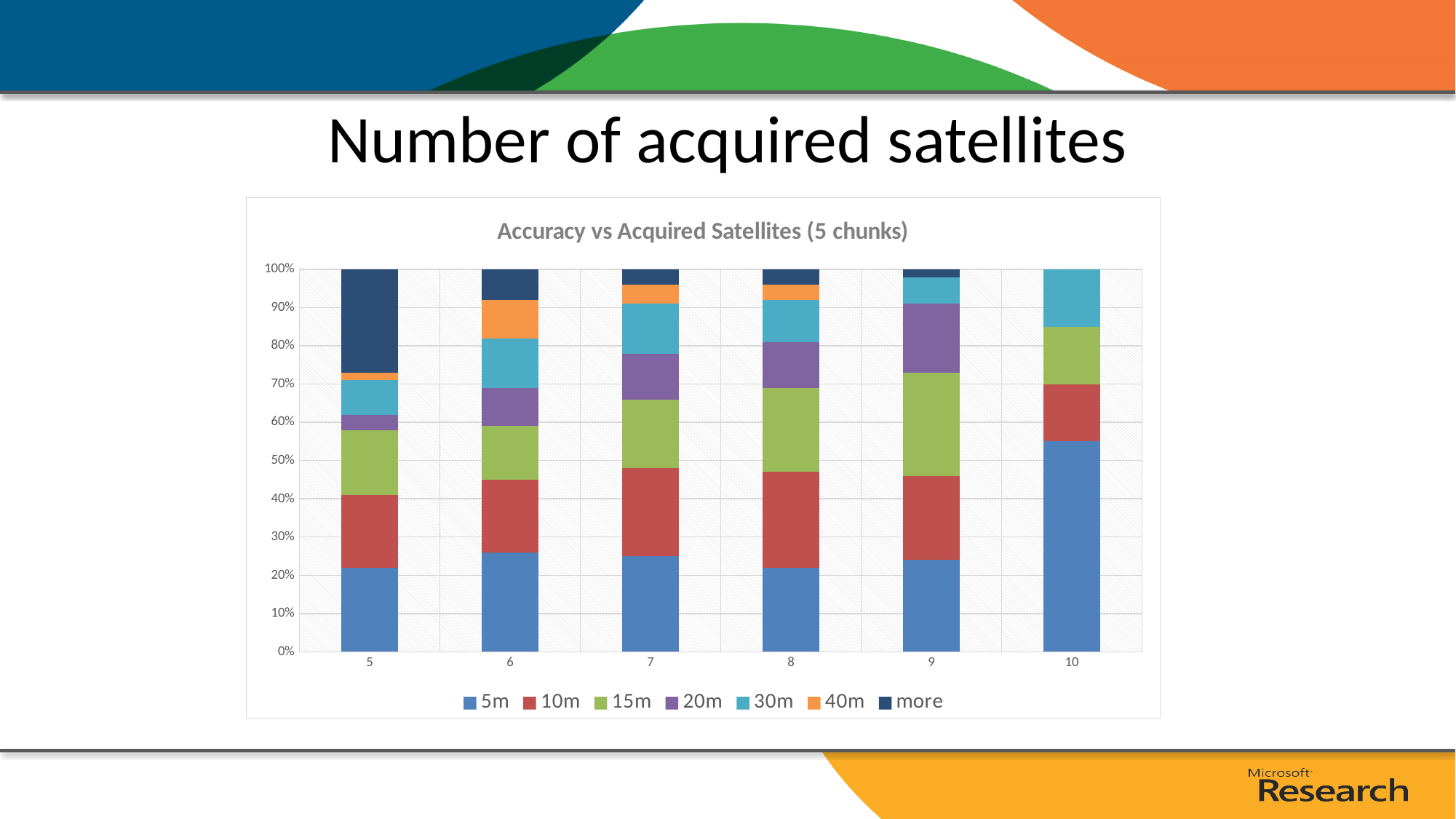
How many series does the legend list? 7 How many categories (numbers of satellites) are shown on the x axis? 6 Which category's bar has no 'more' segment at all? 10 Is the 5m share for 10 satellites greater or less than 50%? greater Which category has the largest 5m share of its bar? 10 Which category has the largest 'more' share of its bar? 5 Which is larger, the 5m share for 10 satellites or the 5m share for 5 satellites? 10 satellites Is the 5m share for 5 satellites greater or less than 30%? less What kind of chart is shown on the slide? Stacked bar chart What is the title of the chart? Accuracy vs Acquired Satellites (5 chunks) What is the top value shown on the y axis? 100% Which is larger, the 'more' share for 5 satellites or the 'more' share for 9 satellites? 5 satellites